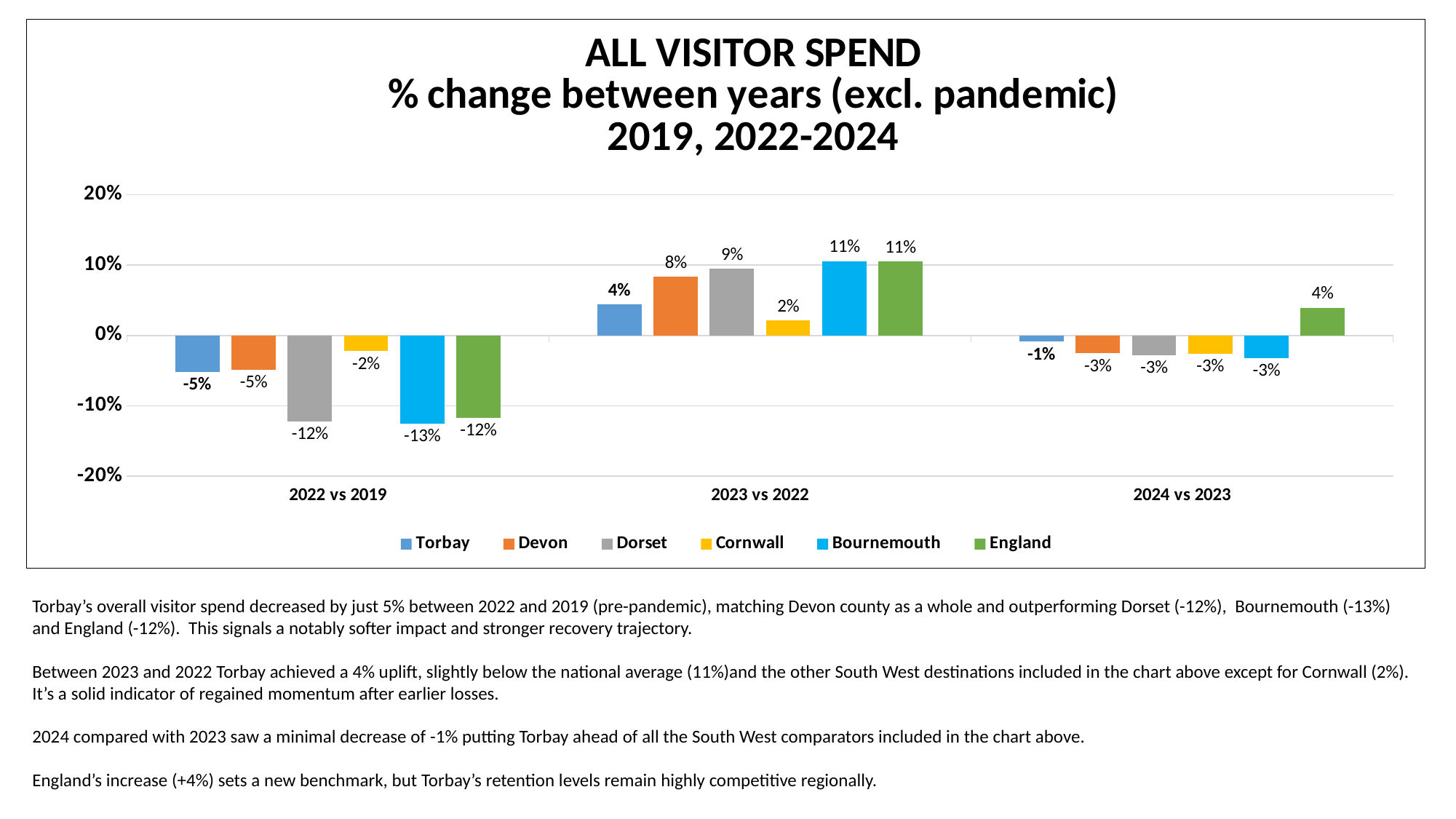
In the 2022 vs 2019 group, which is larger, the value for Cornwall or the value for Dorset? Cornwall What is the value for England in the 2024 vs 2023 group? 4% How many period groups are shown on the x axis? 3 How many series does the legend list? 6 Which series has the highest value in the 2024 vs 2023 group? England What is the difference between Dorset and Torbay in the 2023 vs 2022 group? 5 percentage points What kind of chart is shown? Bar chart Which series has the lowest value in the 2022 vs 2019 group? Bournemouth What is the value for Bournemouth in the 2023 vs 2022 group? 11% What is the value for Cornwall in the 2023 vs 2022 group? 2% What is the value for Torbay in the 2022 vs 2019 group? -5% What colour represents Bournemouth in the chart? Light blue